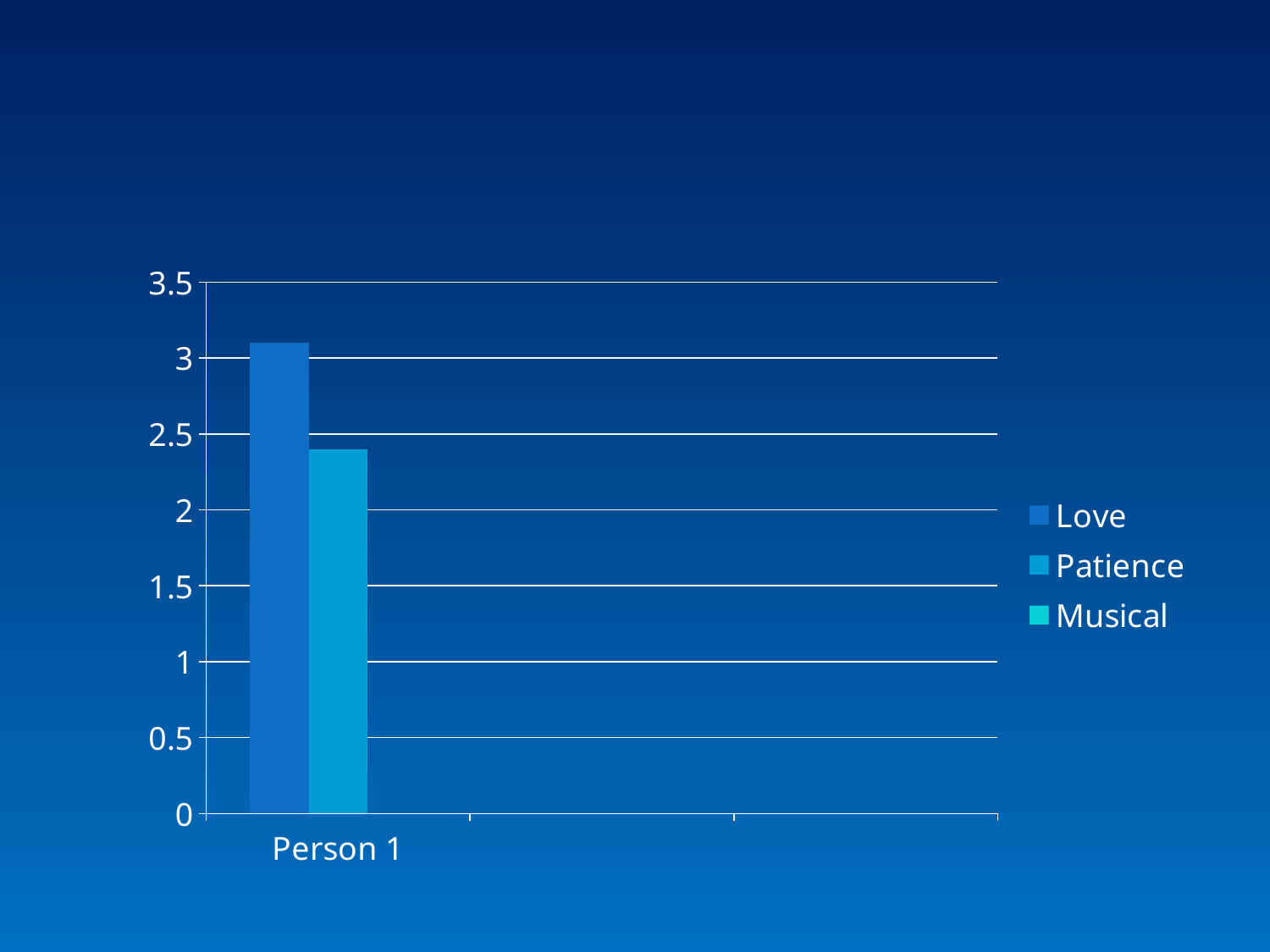
What kind of chart is shown on the slide? bar chart What are the three series names listed in the legend? Love, Patience, Musical How many categories are labelled on the x axis? 1 What is the label of the category on the x axis? Person 1 How many series does the legend list? 3 Is the value for Love for Person 1 greater or less than 3.5? less Is the value for Patience for Person 1 greater or less than 2.5? less For Person 1, is the Love bar or the Patience bar taller? Love Is the value for Patience for Person 1 greater or less than 2? greater What is the highest value shown on the y axis? 3.5 Which series has the tallest bar for Person 1? Love